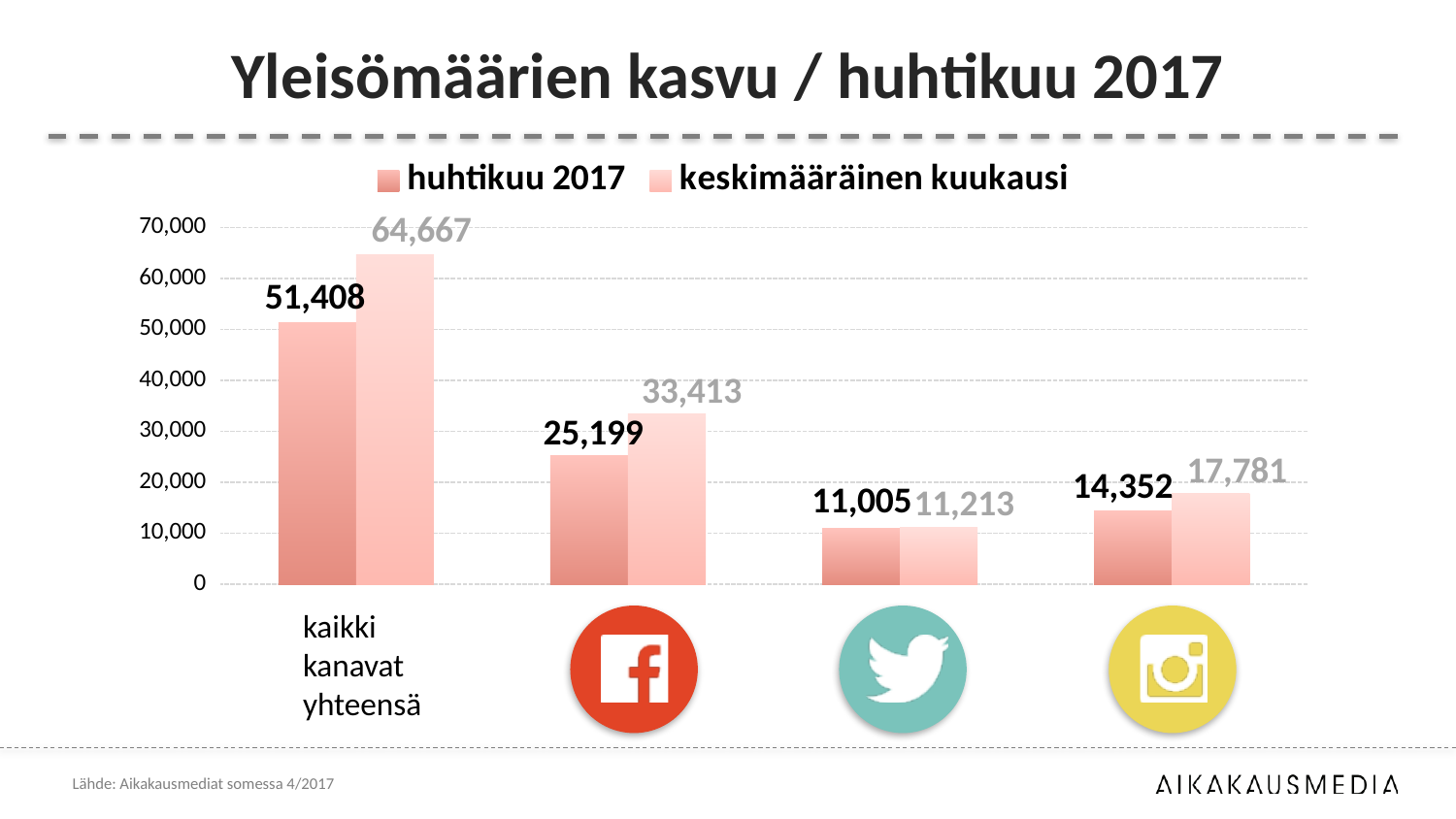
What is the difference between the 'keskimääräinen kuukausi' and 'huhtikuu 2017' values for the Facebook category? 8,214 What is the value for 'keskimääräinen kuukausi' in the 'kaikki kanavat yhteensä' category? 64,667 What is the value for 'huhtikuu 2017' in the 'kaikki kanavat yhteensä' category? 51,408 What kind of chart is shown on the slide? bar chart How many series does the legend list? 2 What is the 'huhtikuu 2017' value for the Facebook category? 25,199 What is the 'keskimääräinen kuukausi' value for the Instagram category? 17,781 Which category has the highest 'keskimääräinen kuukausi' value? kaikki kanavat yhteensä Which is larger for the Twitter category: the 'huhtikuu 2017' value or the 'keskimääräinen kuukausi' value? keskimääräinen kuukausi How many categories are shown on the x axis? 4 Which category has the lowest 'huhtikuu 2017' value? Twitter What is the title of the chart? Yleisömäärien kasvu / huhtikuu 2017